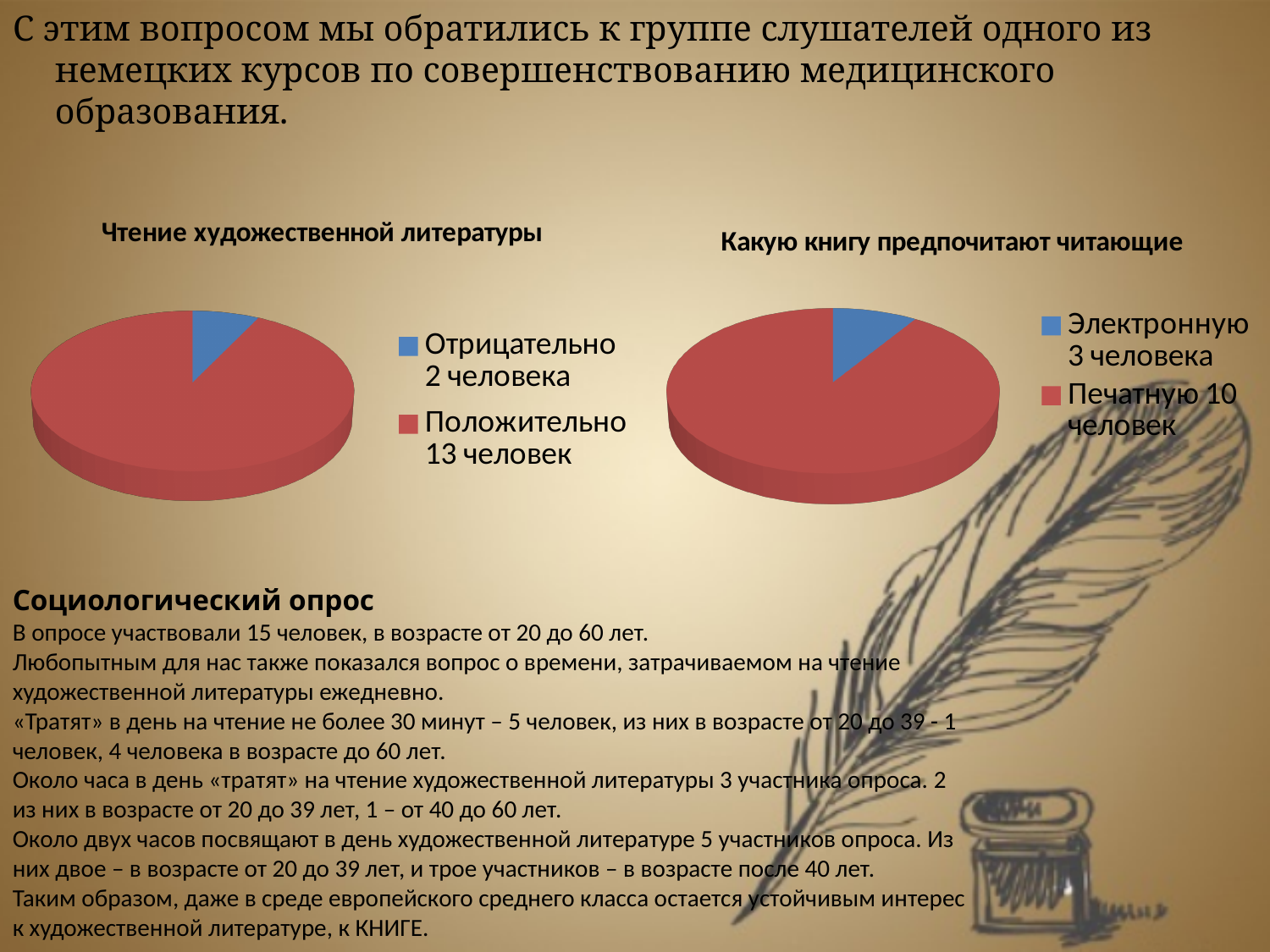
In the chart titled "Какую книгу предпочитают читающие", how many people prefer an electronic book ("Электронную")? 3 человека In the chart titled "Чтение художественной литературы", how many people answered "Отрицательно"? 2 человека In the chart titled "Какую книгу предпочитают читающие", which category has the smallest slice? Электронную In the chart titled "Чтение художественной литературы", what is the difference between the number of positive and negative answers? 11 In the chart titled "Чтение художественной литературы", how many people answered "Положительно"? 13 человек In the chart titled "Чтение художественной литературы", what is the total number of people represented? 15 In the chart titled "Какую книгу предпочитают читающие", how many people prefer a printed book ("Печатную")? 10 человек In the chart titled "Какую книгу предпочитают читающие", what is the total number of people represented? 13 How many entries does the legend of the chart "Какую книгу предпочитают читающие" list? 2 In the chart titled "Какую книгу предпочитают читающие", how many more people prefer printed books than electronic books? 7 What type of chart is the left chart, "Чтение художественной литературы"? Pie chart In the chart titled "Чтение художественной литературы", which category has the largest slice? Положительно